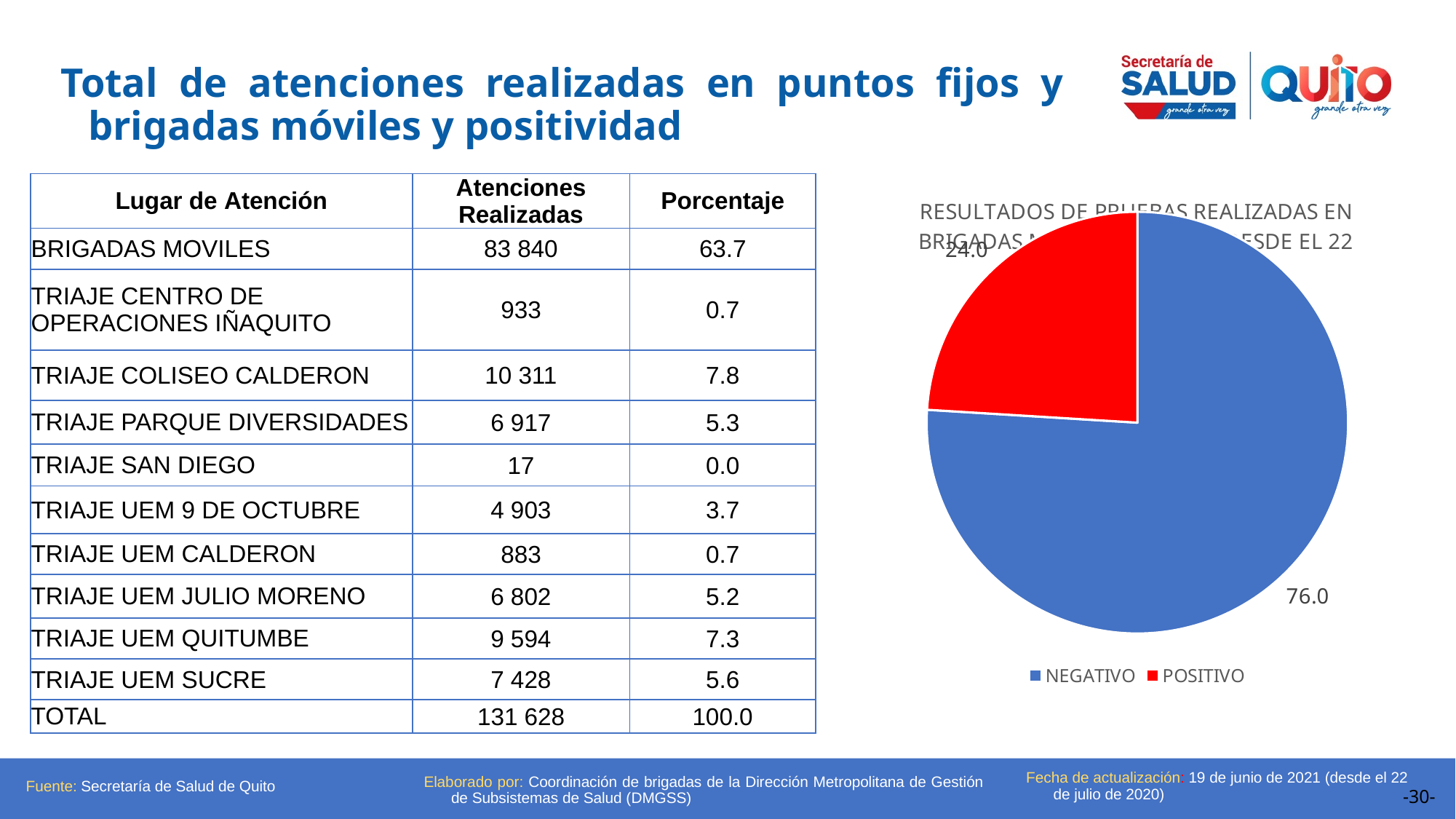
How many entries does the pie chart legend list? 2 In the pie chart, which is larger, NEGATIVO or POSITIVO? NEGATIVO Which slice of the pie chart is the smallest? POSITIVO What is the difference between the NEGATIVO and POSITIVO values in the pie chart? 52.0 In the pie chart, what is the value shown for POSITIVO? 24.0 How many slices does the pie chart have? 2 What kind of chart is shown on the slide? pie chart In the pie chart, what is the value shown for NEGATIVO? 76.0 What colour is the NEGATIVO slice in the pie chart? blue What colour is the POSITIVO slice in the pie chart? red Which slice of the pie chart is the largest? NEGATIVO